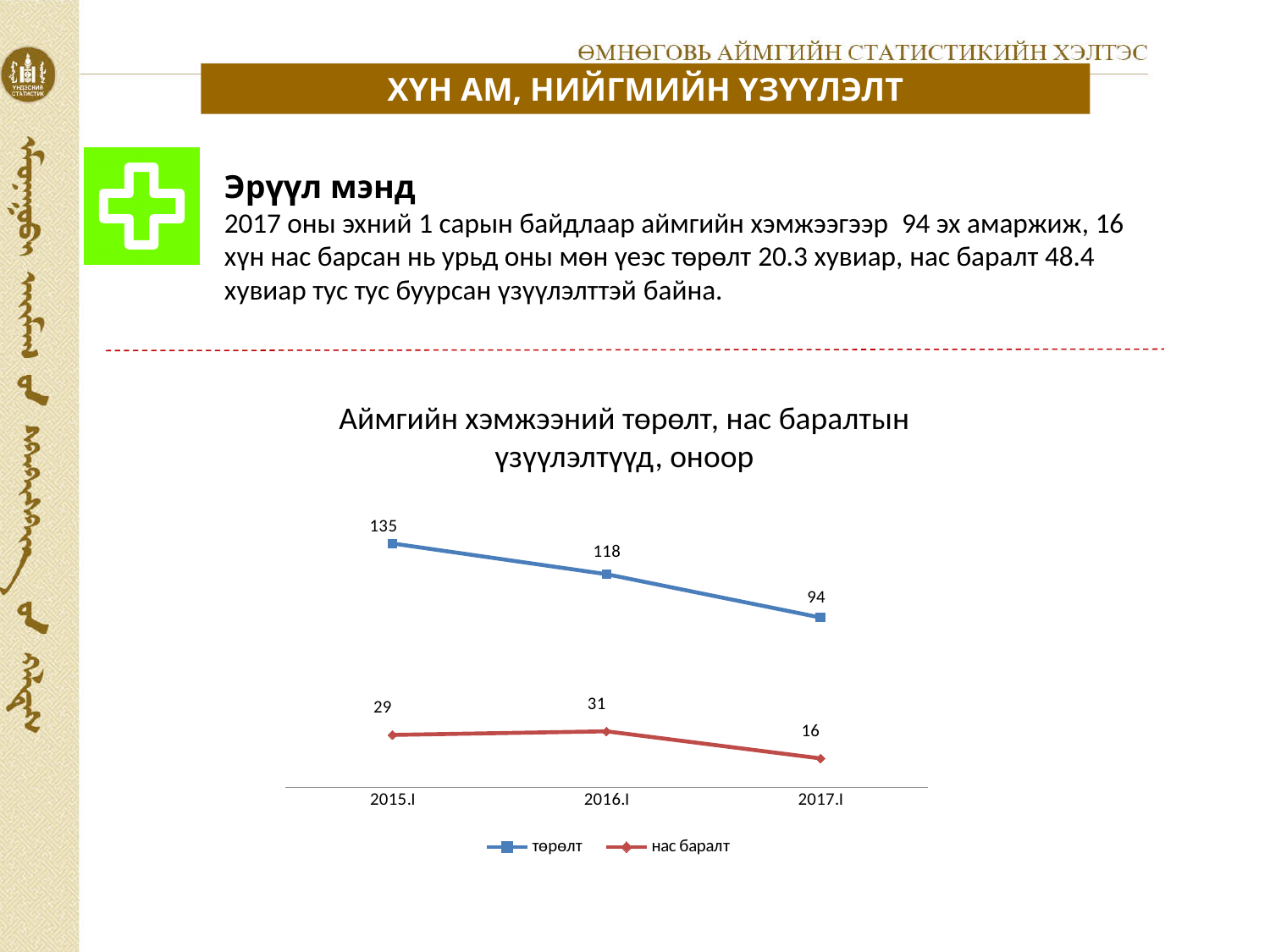
What is the value of төрөлт for 2015.I? 135 In which period is нас баралт highest? 2016.I Which is larger: нас баралт in 2015.I or in 2016.I? 2016.I What is the value of төрөлт for 2016.I? 118 What is the value of нас баралт for 2017.I? 16 What is the difference between төрөлт in 2015.I and 2017.I? 41 What kind of chart is shown? line chart What colour is the нас баралт line? red How many periods are shown on the x axis? 3 How many series does the legend list? 2 Does төрөлт rise or fall from 2015.I to 2017.I? fall In which period is төрөлт lowest? 2017.I